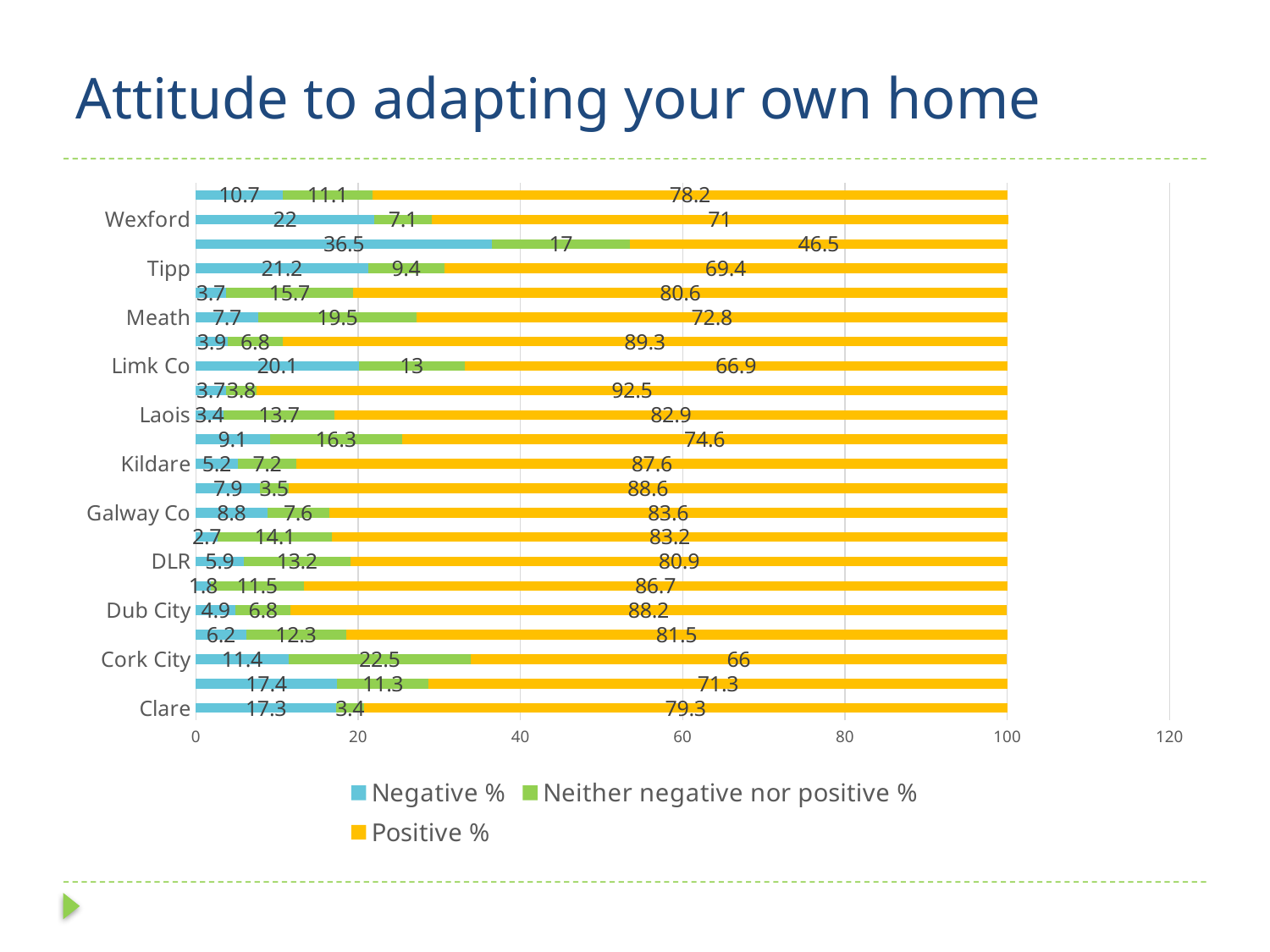
What is the Positive % value for Wexford? 71 What kind of chart is shown on the slide? Stacked bar chart Among the labelled counties, which has the highest Negative % value? Wexford What is the Positive % value for Dub City? 88.2 What is the Neither negative nor positive % value for Cork City? 22.5 Among the labelled counties, which has the lowest Positive % value? Cork City What is the Negative % value for Tipp? 21.2 What is the difference between the Positive % values for Laois and Limk Co? 16 What is the total of the stacked bar for Cork City? 99.9 What is the title of the slide? Attitude to adapting your own home How many series does the legend list? 3 Which has the larger Positive % value, Kildare or Galway Co? Kildare